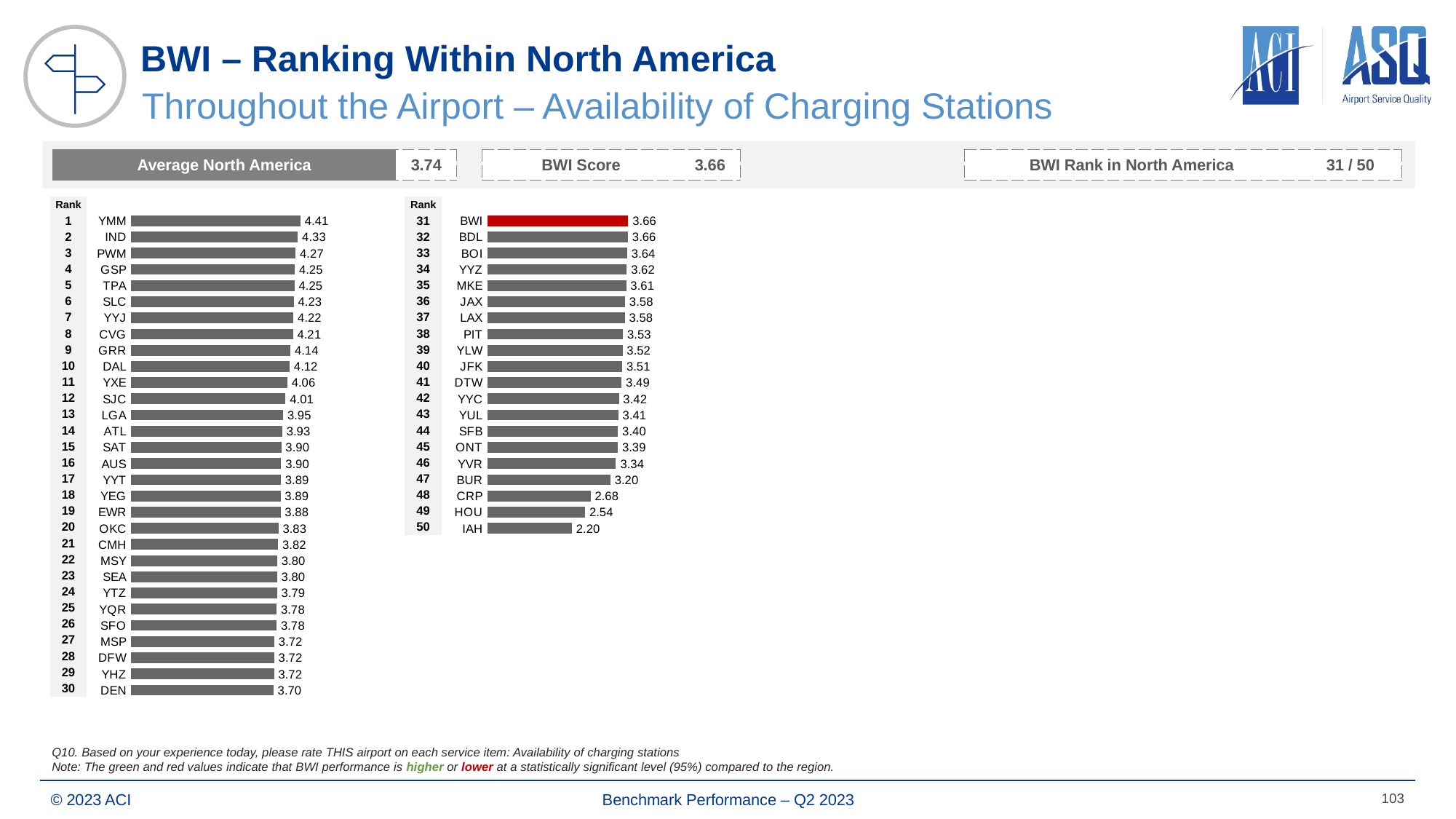
In the right chart (ranks 31–50), which has a larger value, BUR or CRP? BUR In the left chart (ranks 1–30), what is the value for YMM? 4.41 In the right chart (ranks 31–50), which airport has the lowest value? IAH In the right chart (ranks 31–50), what is the value for BWI? 3.66 In the right chart (ranks 31–50), which bar is coloured red? BWI What type of chart is used to show the airport rankings on this slide? Bar chart In the right chart (ranks 31–50), what is the value for IAH? 2.20 In the left chart (ranks 1–30), which airport has the highest value? YMM In the left chart (ranks 1–30), what is the difference between the values for YMM and DEN? 0.71 In the right chart (ranks 31–50), what is the difference between the values for BWI and IAH? 1.46 How many airports are plotted in the left chart (ranks 1–30)? 30 How many airports are plotted in the right chart (ranks 31–50)? 20